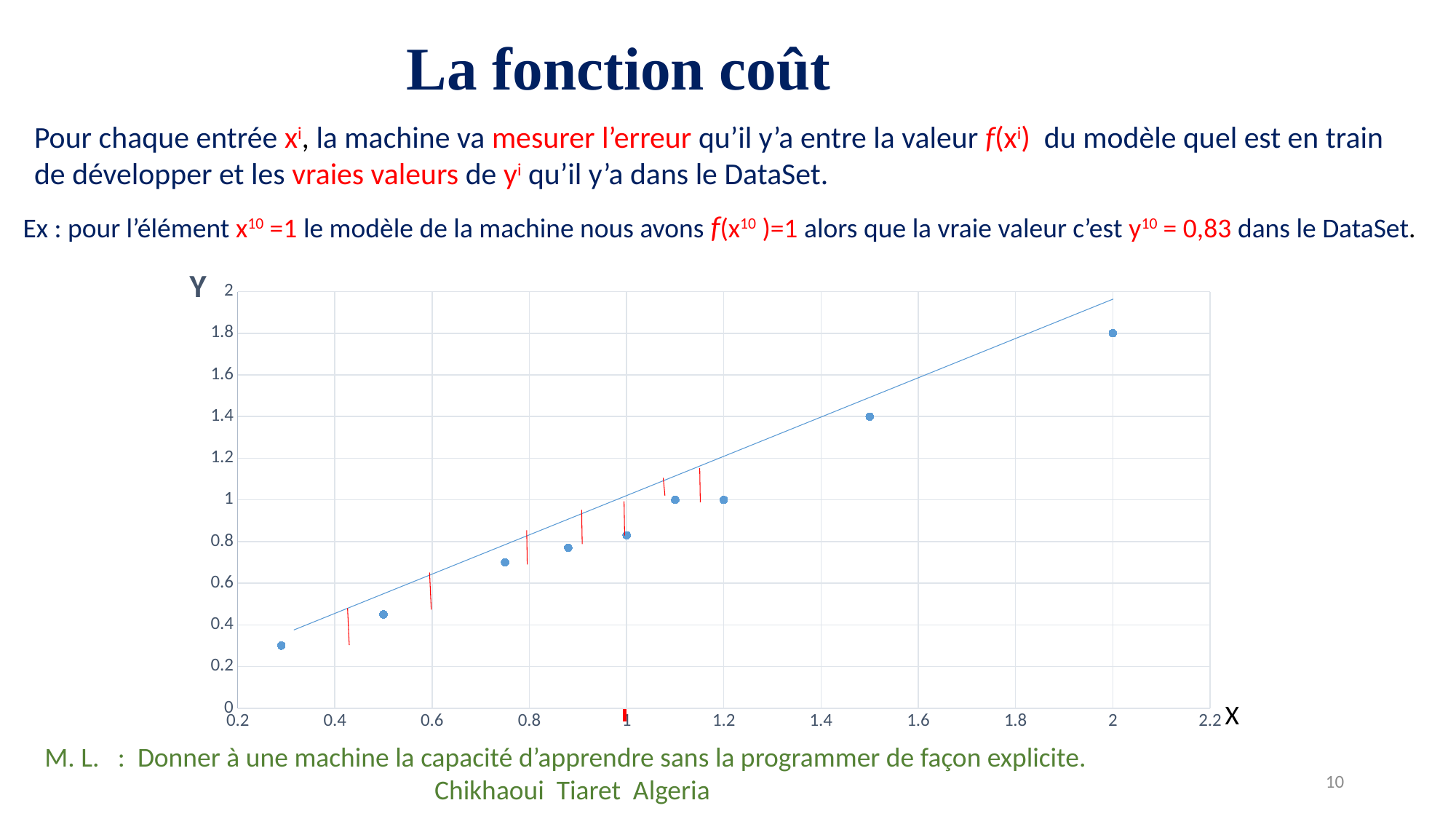
Is the Y value of the point at X = 1.5 greater or less than 1.2? greater What is the label of the vertical axis? Y At which X value is the highest plotted point located? 2 According to the slide, what is the true value y for the element x = 1? 0,83 What is the highest tick value shown on the horizontal axis? 2.2 What is the Y value of the data point at X = 2? 1.8 Is the Y value of the point at X = 0.5 greater or less than 0.6? less What is the Y value of the data point at X = 1.5? 1.4 What kind of chart is shown on the slide? scatter chart Do the plotted Y values rise or fall as X increases? rise Which point has the larger Y value: the one at X = 1.5 or the one at X = 2? the one at X = 2 How many data points are plotted on the chart? 9